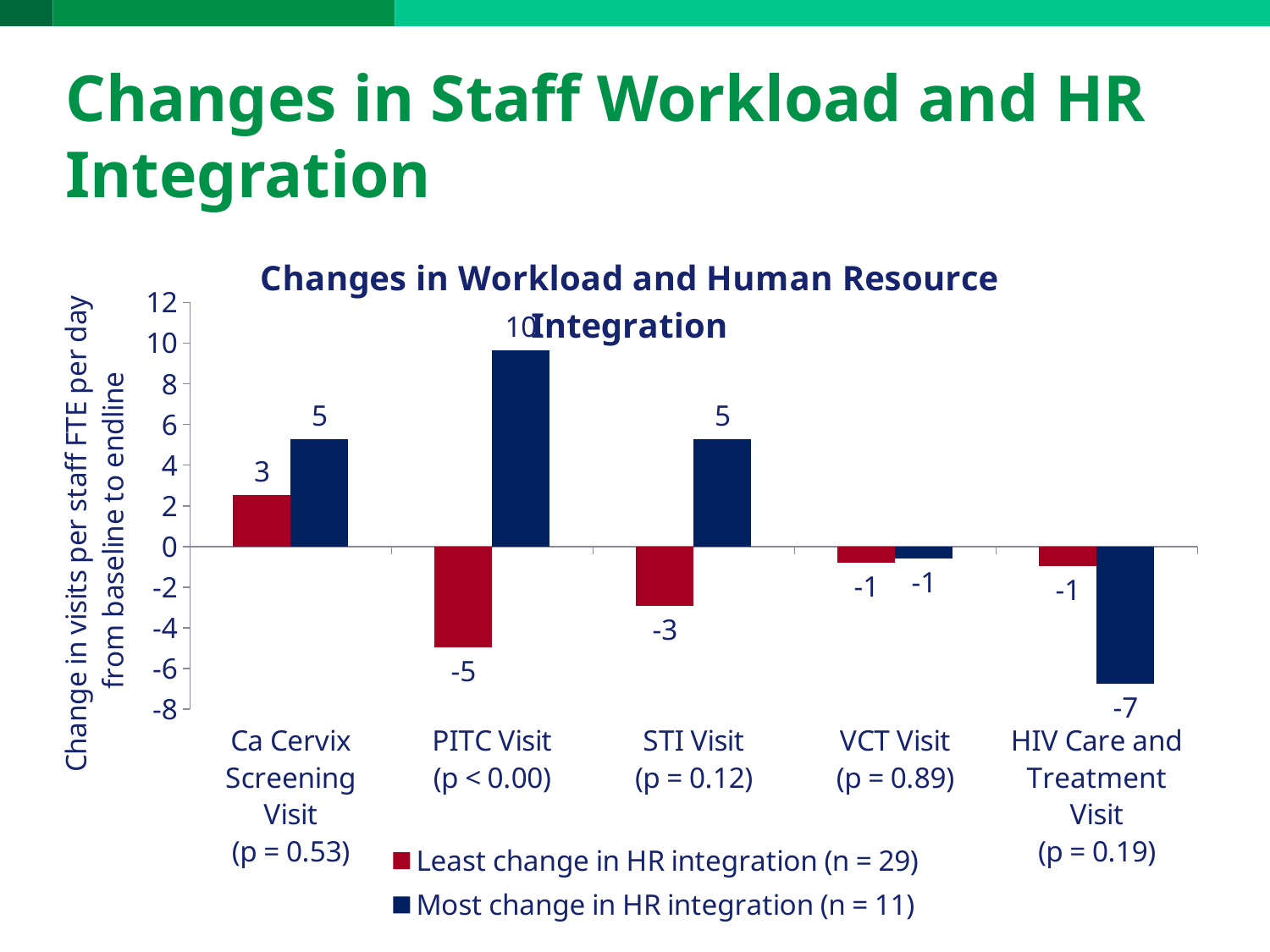
What is the difference between the Most change and Least change values for STI Visit? 8 How many series does the legend list? 2 Which is larger for Ca Cervix Screening Visit: the Least change in HR integration value or the Most change in HR integration value? Most change in HR integration What is the value for PITC Visit in the Least change in HR integration series? -5 How many visit categories are shown on the x axis? 5 What is the value for STI Visit in the Least change in HR integration series? -3 What is the value for HIV Care and Treatment Visit in the Most change in HR integration series? -7 Which category has the lowest value in the Most change in HR integration series? HIV Care and Treatment Visit What kind of chart is shown on the slide? bar chart Is the value for PITC Visit in the Most change in HR integration series greater or less than 8? greater What is the value for Ca Cervix Screening Visit in the Least change in HR integration series? 3 What is the value for Ca Cervix Screening Visit in the Most change in HR integration series? 5